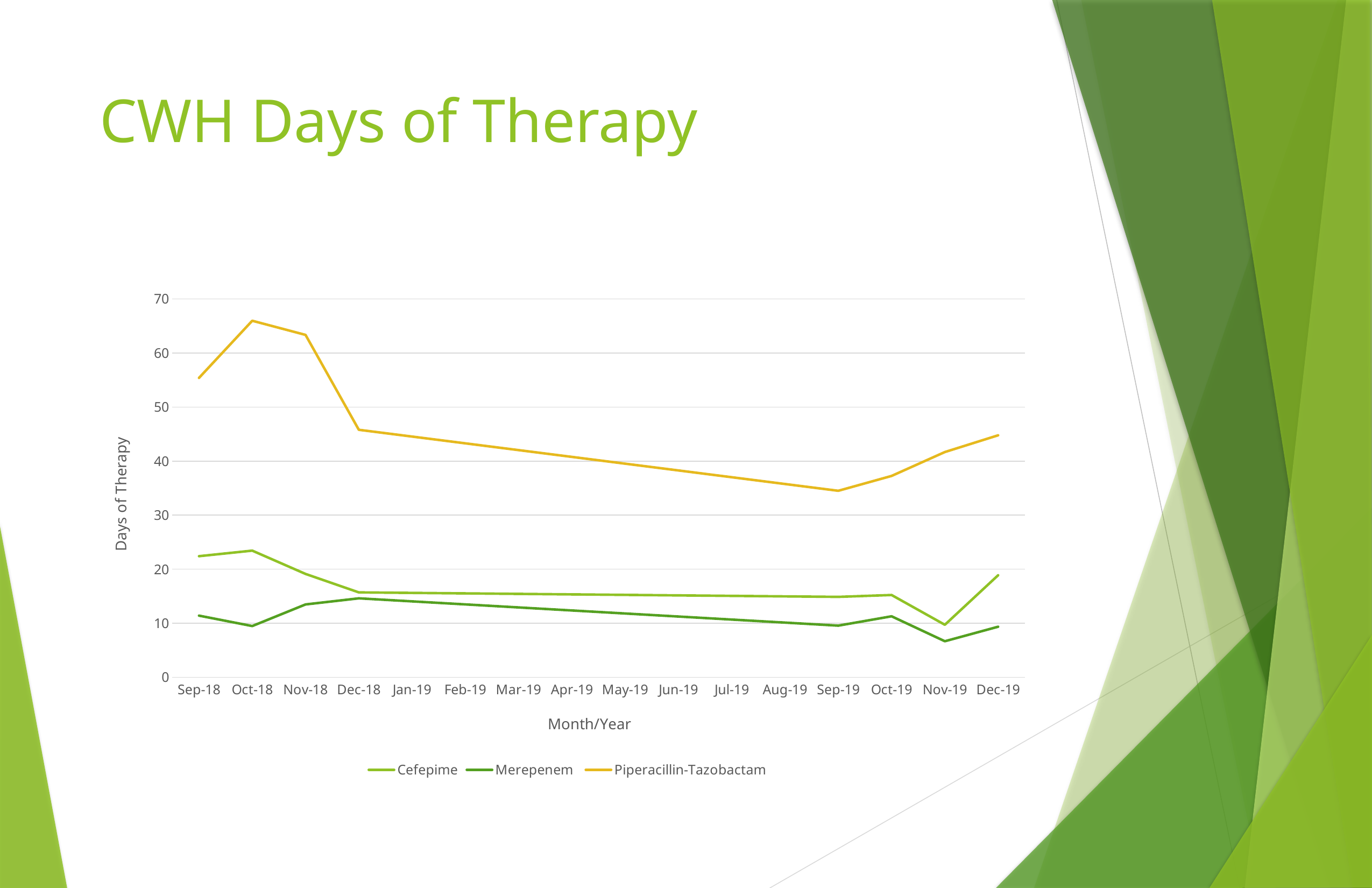
What is the title of the chart's y axis? Days of Therapy Which series has the highest values throughout the chart? Piperacillin-Tazobactam In which month does Piperacillin-Tazobactam reach its highest value? Oct-18 Is the value for Merepenem in Nov-19 greater or less than 10? less Is the value for Piperacillin-Tazobactam in Oct-18 greater or less than 60? greater How many series does the legend list? 3 Does the Piperacillin-Tazobactam line rise or fall from Dec-18 to Sep-19? fall Is the value for Piperacillin-Tazobactam in Sep-19 greater or less than 40? less In which month does Merepenem reach its lowest value? Nov-19 What kind of chart is shown on the slide? line chart In which month does Piperacillin-Tazobactam reach its lowest value? Sep-19 How many months are shown along the x axis? 16